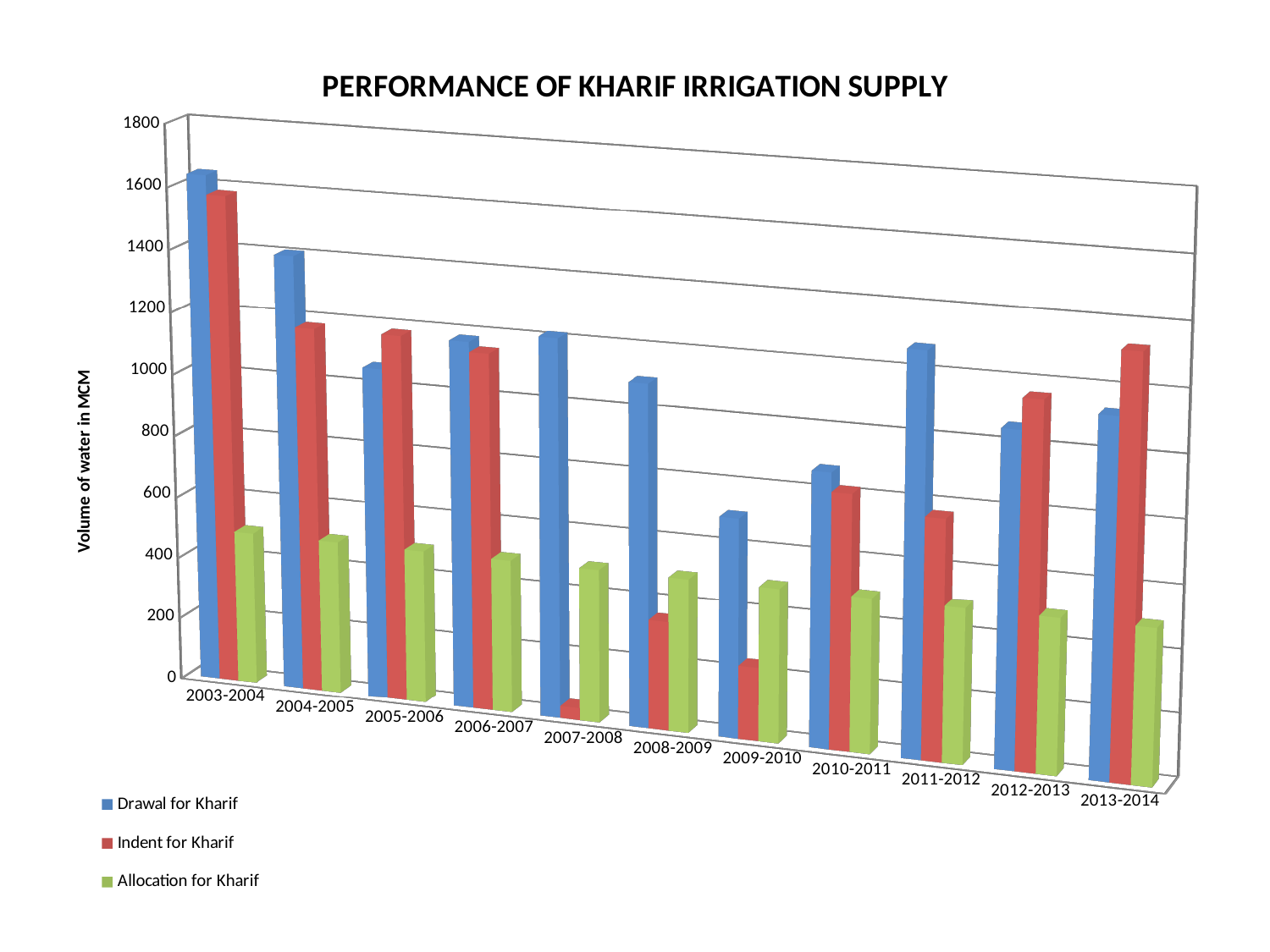
Which year has the highest Indent for Kharif? 2003-2004 Which year has the lowest Drawal for Kharif? 2009-2010 What kind of chart is shown on the slide? bar chart In 2013-2014, which is larger: Drawal for Kharif or Indent for Kharif? Indent for Kharif Which year has the highest Drawal for Kharif? 2003-2004 Is the Drawal for Kharif in 2003-2004 greater or less than 1400? greater Is the Indent for Kharif in 2008-2009 greater or less than 400? less Is the Allocation for Kharif in 2003-2004 greater or less than 600? less How many series does the legend list? 3 How many year categories are shown on the x axis? 11